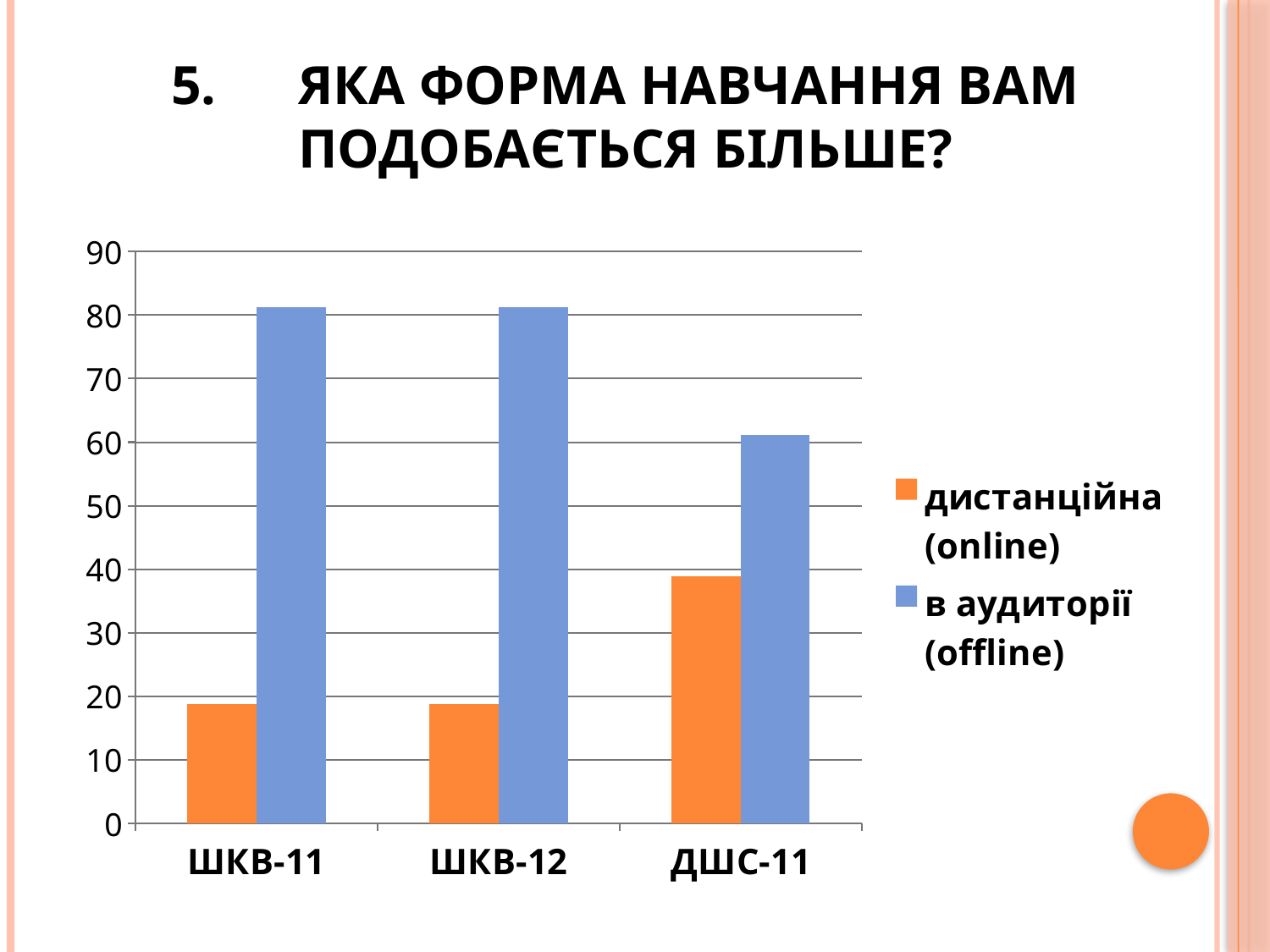
Is the value for в аудиторії (offline) in ДШС-11 greater or less than 60? greater Which is larger: the дистанційна (online) value for ДШС-11 or the дистанційна (online) value for ШКВ-11? ДШС-11 How many series does the chart legend list? 2 Which category has the lowest value for the в аудиторії (offline) series? ДШС-11 What kind of chart is shown on the slide? bar chart Is the value for дистанційна (online) in ДШС-11 greater or less than 40? less Is the value for в аудиторії (offline) in ШКВ-11 greater or less than 80? greater For ДШС-11, which is larger: дистанційна (online) or в аудиторії (offline)? в аудиторії (offline) How many categories are shown on the x axis of the chart? 3 Which colour represents the дистанційна (online) series in the chart? orange Which category has the highest value for the дистанційна (online) series? ДШС-11